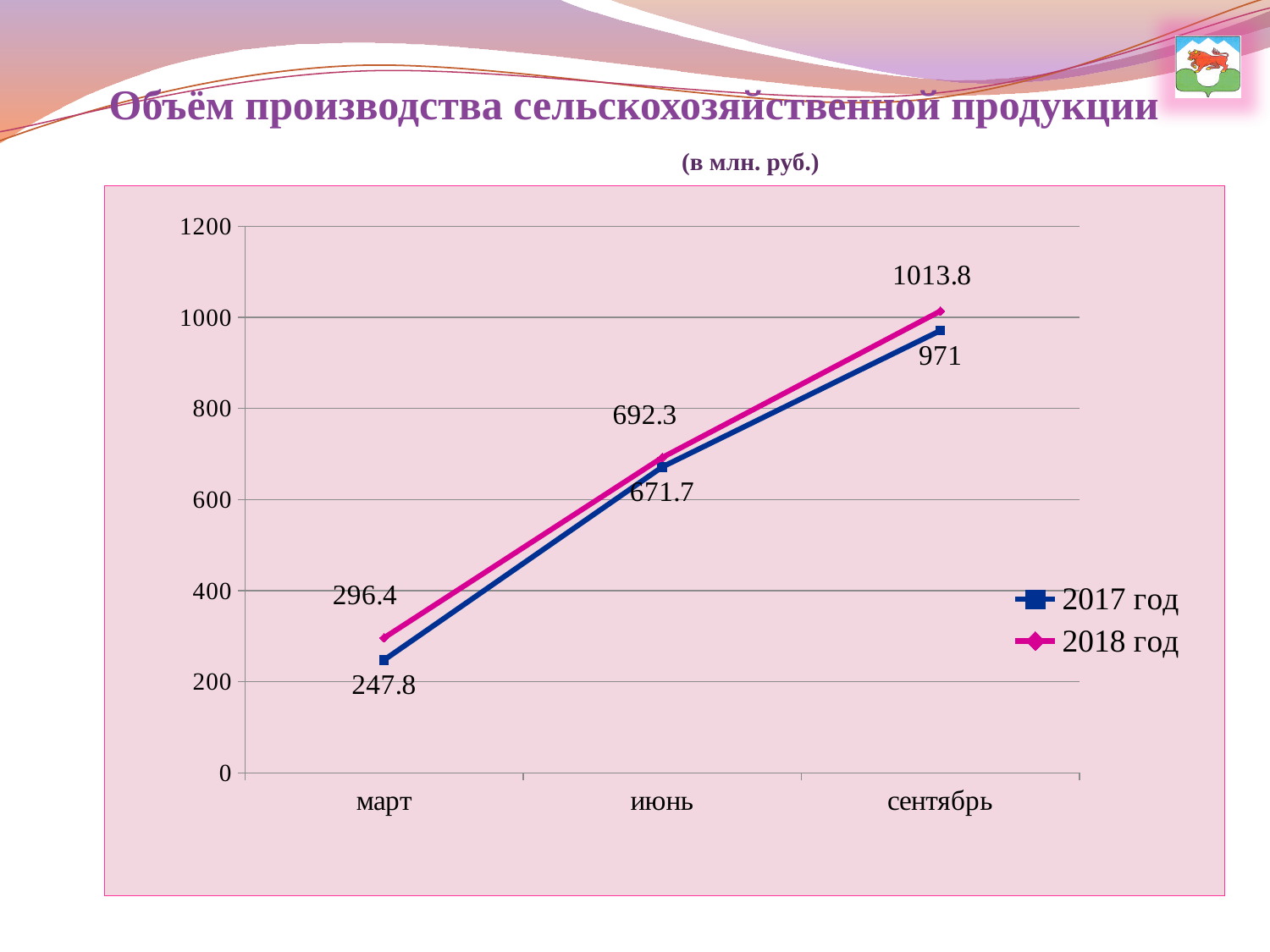
What kind of chart is shown on the slide? line chart Which is larger in июнь: the value for 2017 год or for 2018 год? 2018 год What is the value for 2017 год in март? 247.8 What is the value for 2018 год in март? 296.4 What is the value for 2018 год in сентябрь? 1013.8 How many months are shown on the x axis? 3 What is the value for 2017 год in июнь? 671.7 How many series does the legend list? 2 In which month is the value for 2018 год highest? сентябрь In which month is the value for 2017 год lowest? март Do the values for 2017 год rise or fall from март to сентябрь? rise What is the difference between the 2018 год and 2017 год values in сентябрь? 42.8